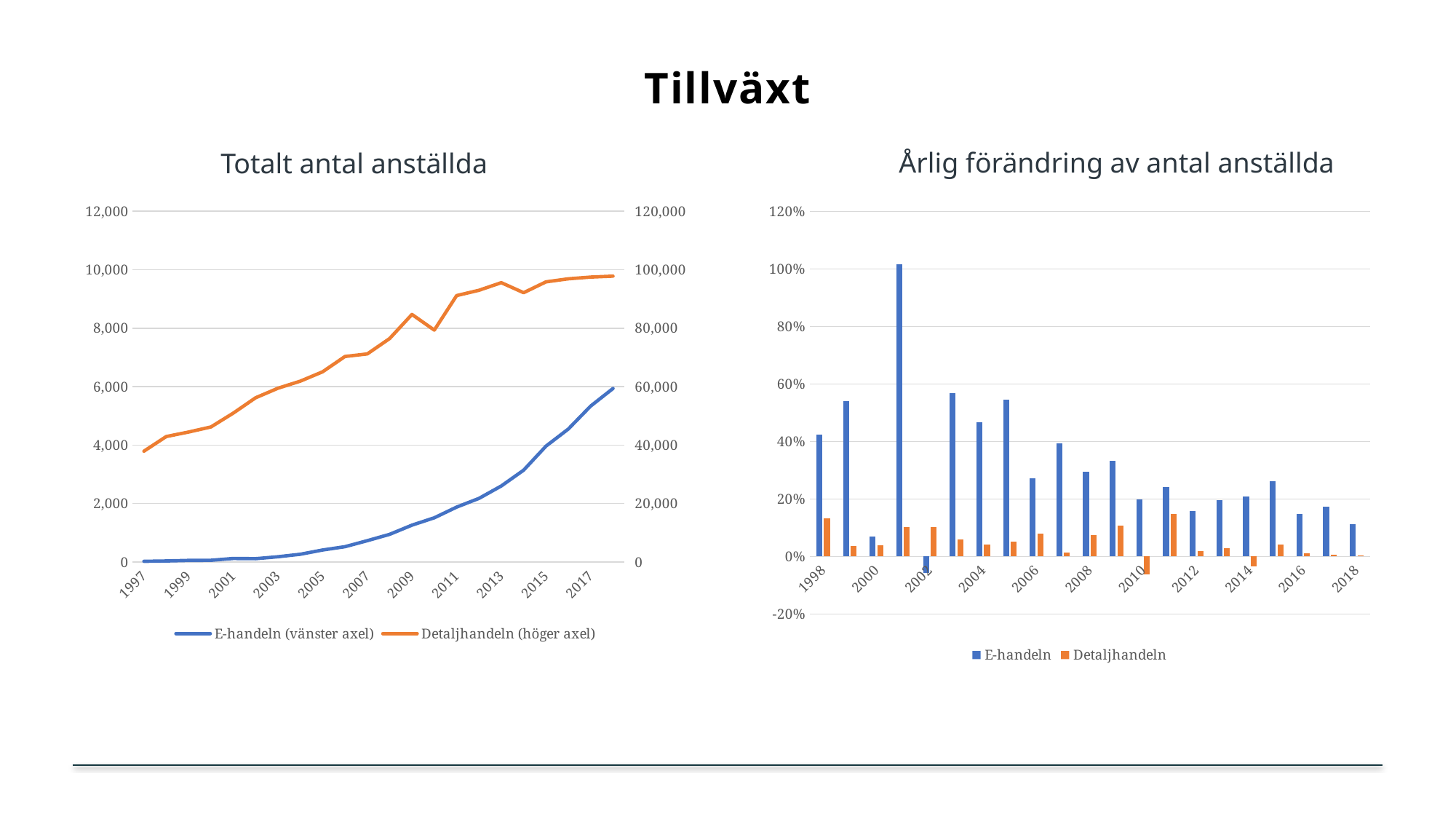
In the right chart "Årlig förändring av antal anställda", is the E-handeln value for 2001 greater or less than 80%? greater In the left chart "Totalt antal anställda", which axis does the legend say the E-handeln series is plotted on? vänster axel In the right chart "Årlig förändring av antal anställda", which is larger in 1999: the E-handeln bar or the Detaljhandeln bar? E-handeln In the right chart "Årlig förändring av antal anställda", which year has the highest E-handeln bar? 2001 In the left chart "Totalt antal anställda", does the E-handeln line rise or fall from 1997 to 2018? rise What kind of chart is the left chart titled "Totalt antal anställda"? line chart In the left chart "Totalt antal anställda", how many series does the legend list? 2 What kind of chart is the right chart titled "Årlig förändring av antal anställda"? bar chart In the right chart "Årlig förändring av antal anställda", is the E-handeln value for 2018 greater or less than 20%? less In the right chart "Årlig förändring av antal anställda", which year has the lowest E-handeln bar? 2002 In the right chart "Årlig förändring av antal anställda", which year has the lowest Detaljhandeln bar? 2010